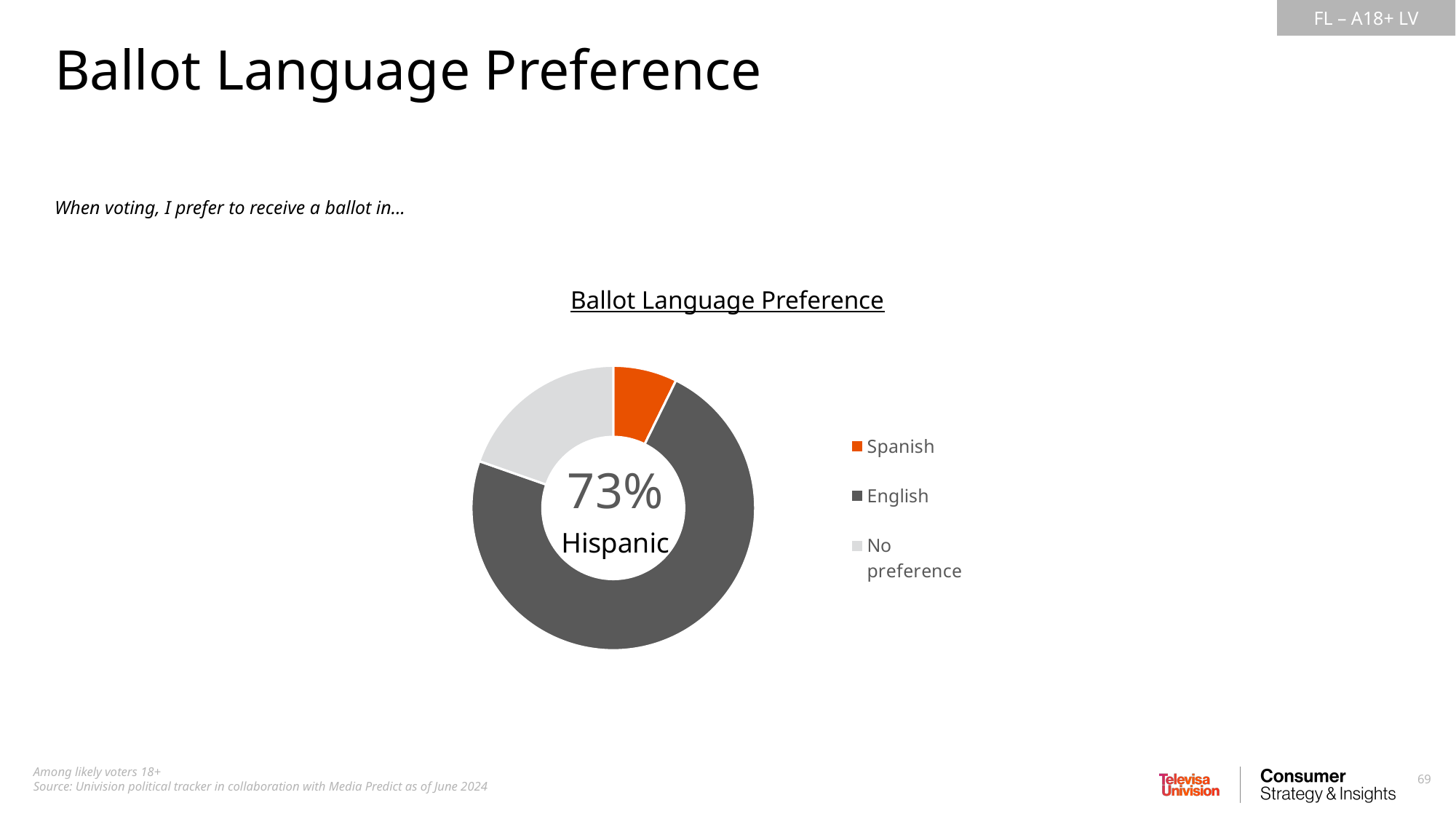
What word appears below the percentage in the centre of the donut chart? Hispanic Which legend category is shown in orange? Spanish Which slice is larger, English or No preference? English Which category has the largest slice of the donut chart? English What is the title of the chart? Ballot Language Preference What kind of chart is shown on the slide? Pie chart (donut) Which slice is larger, Spanish or No preference? No preference How many categories does the chart's legend list? 3 What percentage is printed in the centre of the donut chart? 73% Which category has the smallest slice of the donut chart? Spanish